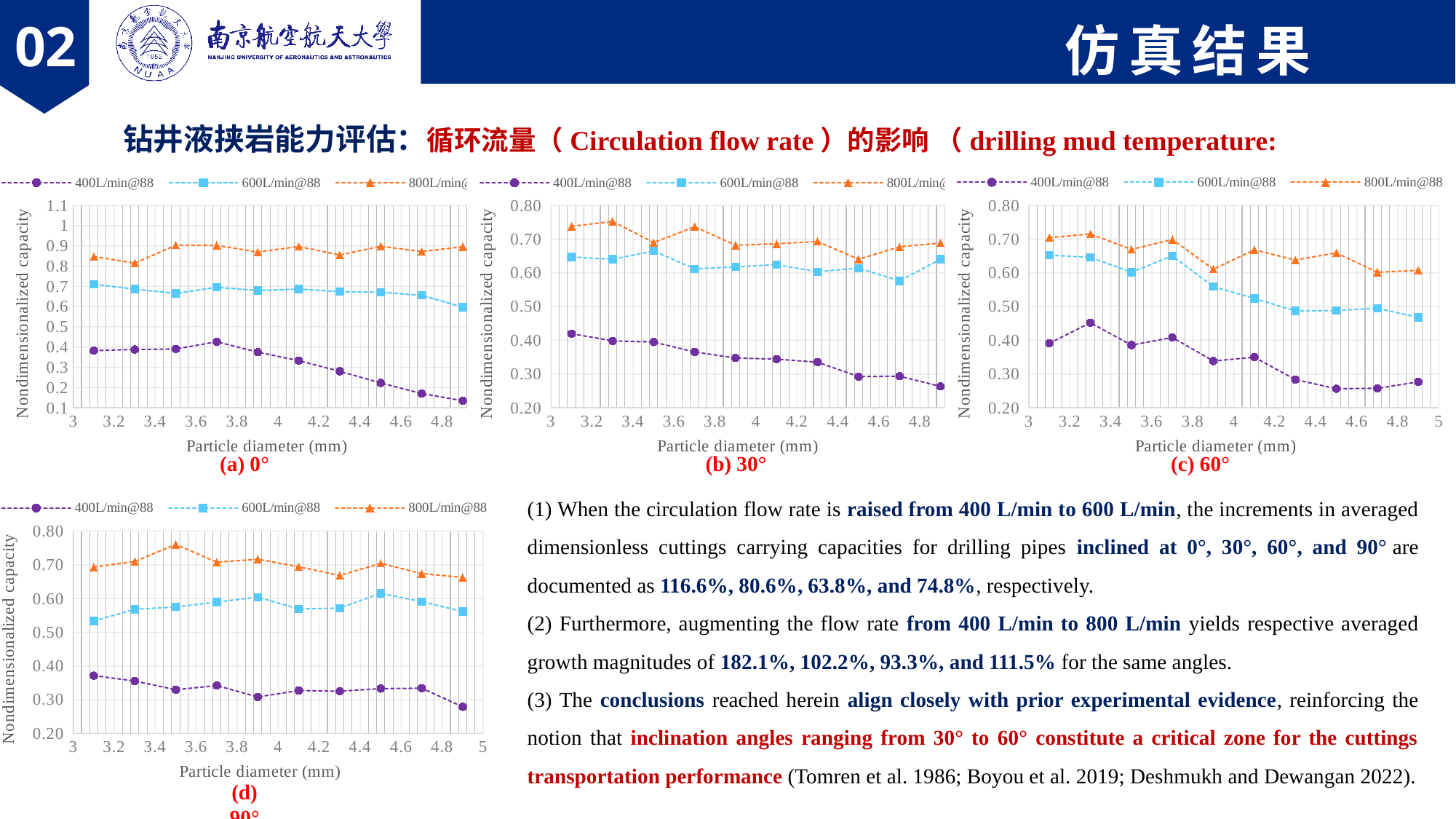
In chart (c) 60°, at particle diameter 3.1 mm, which series has the larger value: 600L/min@88 or 400L/min@88? 600L/min@88 In chart (d) 90°, which series has the lowest values across the particle diameters? 400L/min@88 In chart (d) 90°, is the value of the 800L/min@88 series at particle diameter 3.5 mm greater or less than 0.70? greater In chart (c) 60°, does the 600L/min@88 series rise or fall as particle diameter increases? fall In chart (a) 0°, is the value of the 400L/min@88 series at particle diameter 4.9 mm greater or less than 0.2? less How many series does the legend of chart (b) 30° list? 3 In chart (a) 0°, does the 400L/min@88 series rise or fall as particle diameter increases? fall What is the x-axis title of chart (b) 30°? Particle diameter (mm) In chart (a) 0°, which series has the highest values across the particle diameters? 800L/min@88 In chart (a) 0°, how many data points does the 400L/min@88 series have? 10 What kind of chart is chart (a) 0°? line chart In chart (b) 30°, is the value of the 800L/min@88 series at particle diameter 3.3 mm greater or less than 0.70? greater